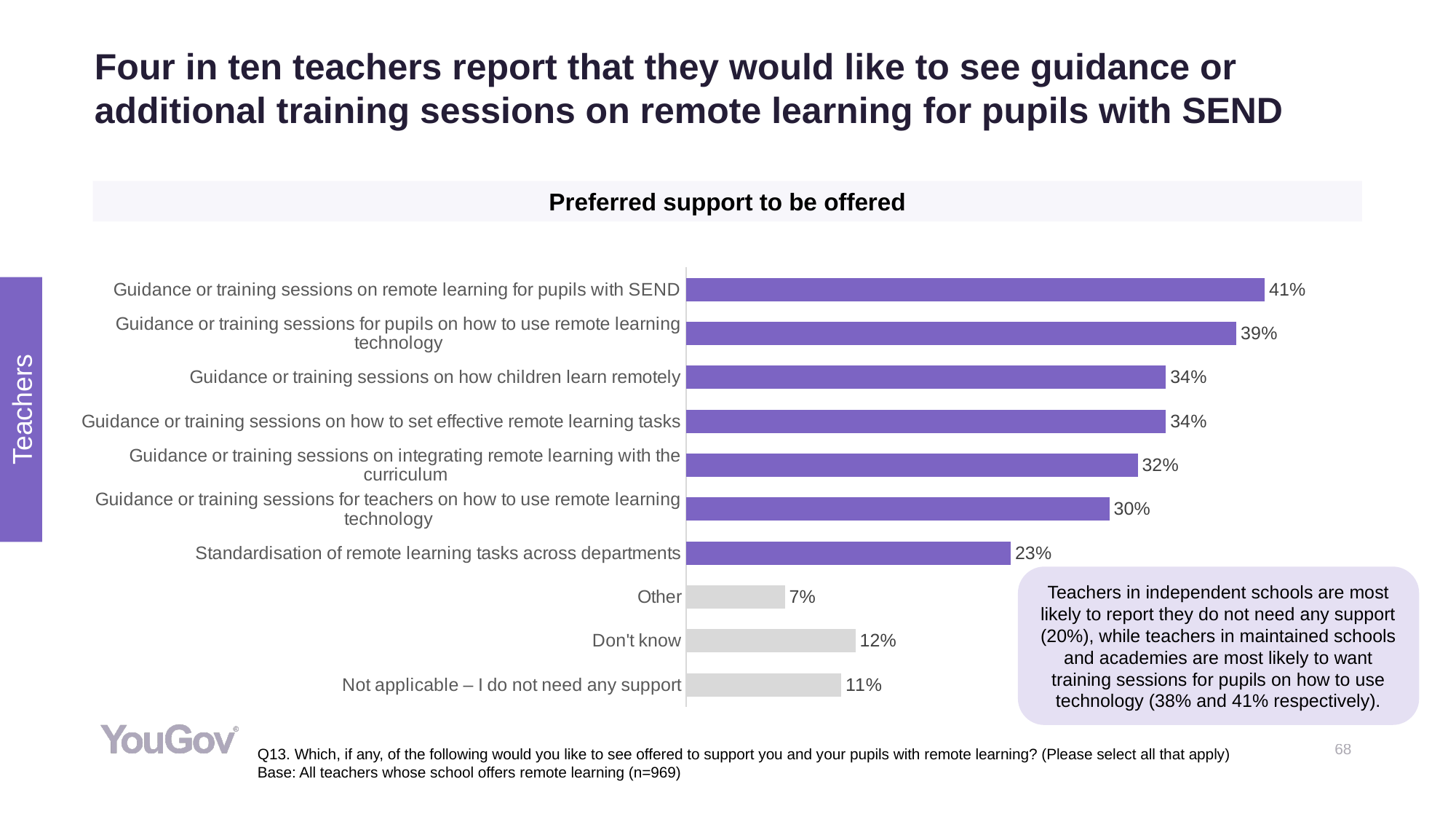
Which is larger: the value for 'Guidance or training sessions on integrating remote learning with the curriculum' or 'Guidance or training sessions for teachers on how to use remote learning technology'? Guidance or training sessions on integrating remote learning with the curriculum What is the value for 'Not applicable – I do not need any support'? 11% What is the difference between the values for 'Don't know' and 'Other'? 5 percentage points Which category has the highest value in the chart? Guidance or training sessions on remote learning for pupils with SEND What is the difference between the value for 'Guidance or training sessions on remote learning for pupils with SEND' and 'Guidance or training sessions for pupils on how to use remote learning technology'? 2 percentage points Which category has the lowest value in the chart? Other What is the title of the chart? Preferred support to be offered What percentage of teachers answered 'Don't know'? 12% What is the value for 'Standardisation of remote learning tasks across departments'? 23% What percentage of teachers would like guidance or training sessions on remote learning for pupils with SEND? 41% What type of chart is shown on the slide? Bar chart How many categories are shown in the chart? 10